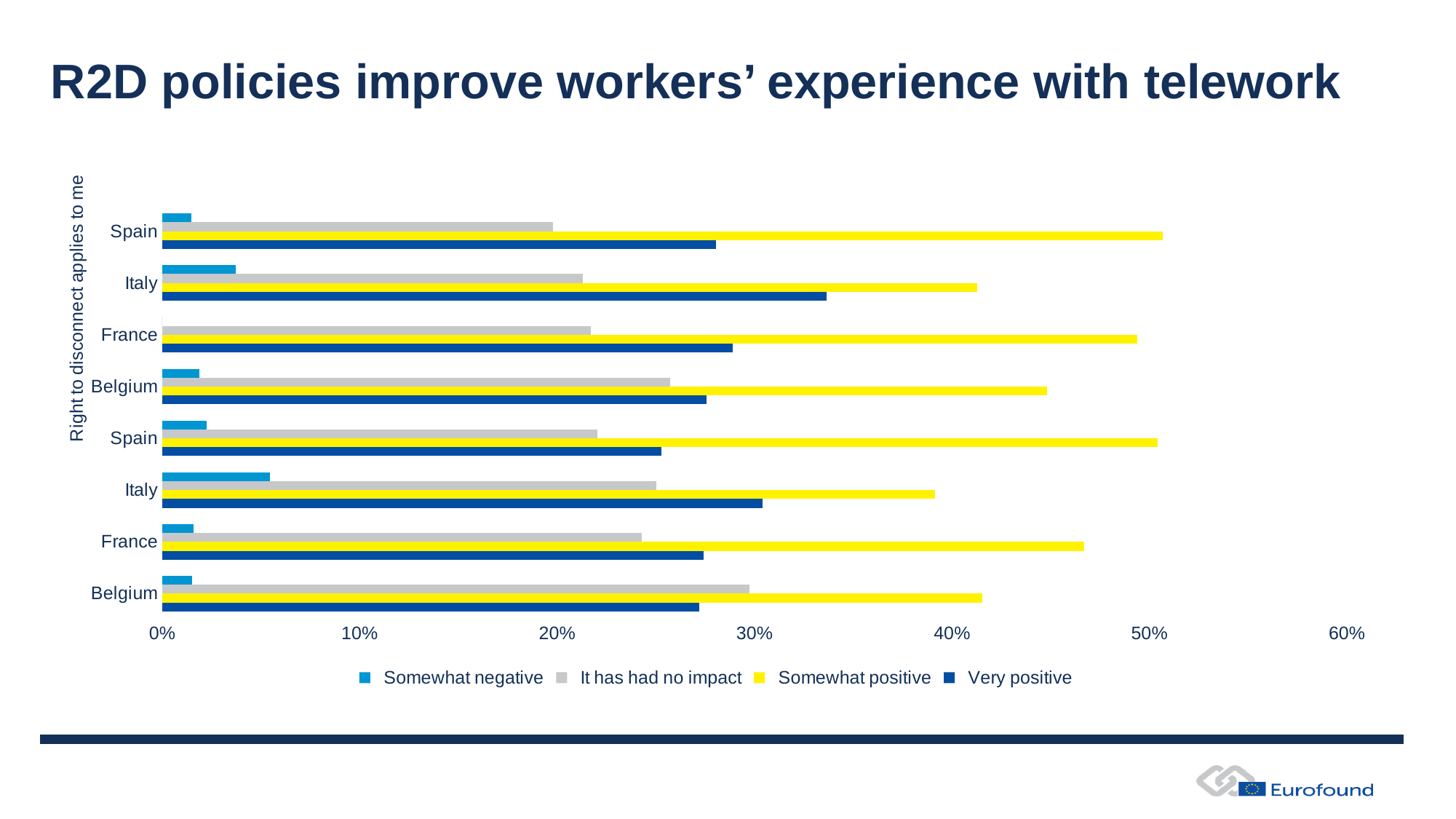
In the top group, which is larger: the 'Very positive' value for Spain or for Italy? Italy Which row has the largest 'Somewhat negative' bar? Italy (bottom group) In the bottom group, is the 'Somewhat negative' value for Italy greater or less than 10%? less In the top group, is the 'Somewhat positive' value for Italy greater or less than 40%? greater Which row has the smallest 'Somewhat positive' bar? Italy (bottom group) In the top group, is the 'Very positive' value for Italy greater or less than 30%? greater In the top group, which is larger: the 'Somewhat positive' value for Italy or for Belgium? Belgium How many category rows (country labels) are plotted on the y axis? 8 Which legend entry is shown in yellow? Somewhat positive How many series does the legend list? 4 Which series has the highest 'Very positive' value across all rows? Italy (top group) What kind of chart is shown on the slide? bar chart